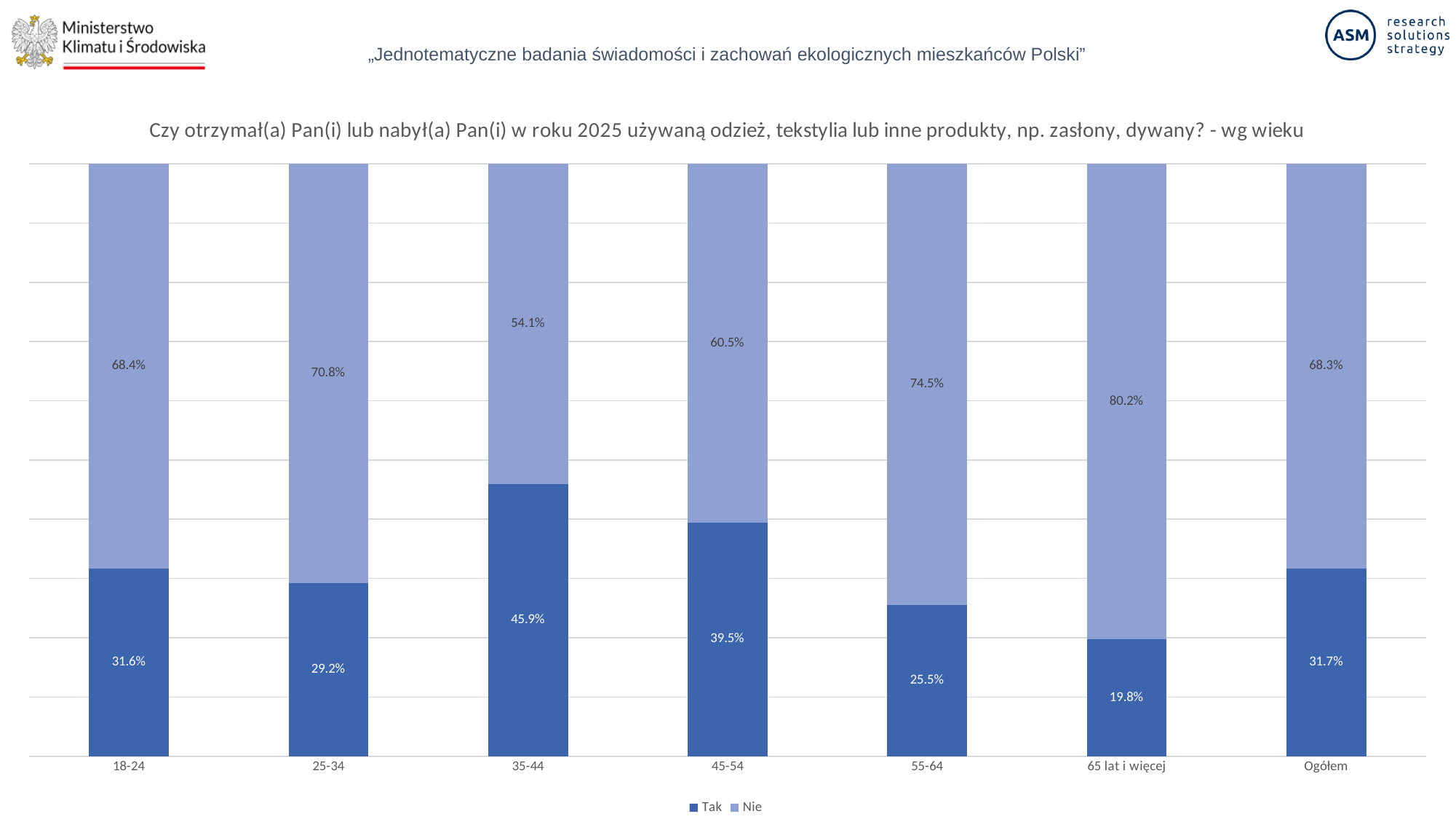
What kind of chart is shown on the slide? Stacked bar chart What is the 'Nie' value for the 65 lat i więcej age group? 80.2% How many categories are shown on the x axis? 7 What is the 'Tak' value for the 35-44 age group? 45.9% What is the 'Tak' value for Ogółem? 31.7% Which age group has the highest 'Tak' value? 35-44 Which age group has the highest 'Nie' value? 65 lat i więcej How many series does the legend list? 2 Which age group has the lowest 'Tak' value? 65 lat i więcej What is the difference between the 'Tak' values for 35-44 and 45-54? 6.4% What are the two legend entries of the chart? Tak, Nie Which is larger, the 'Tak' value for 18-24 or for 25-34? 18-24